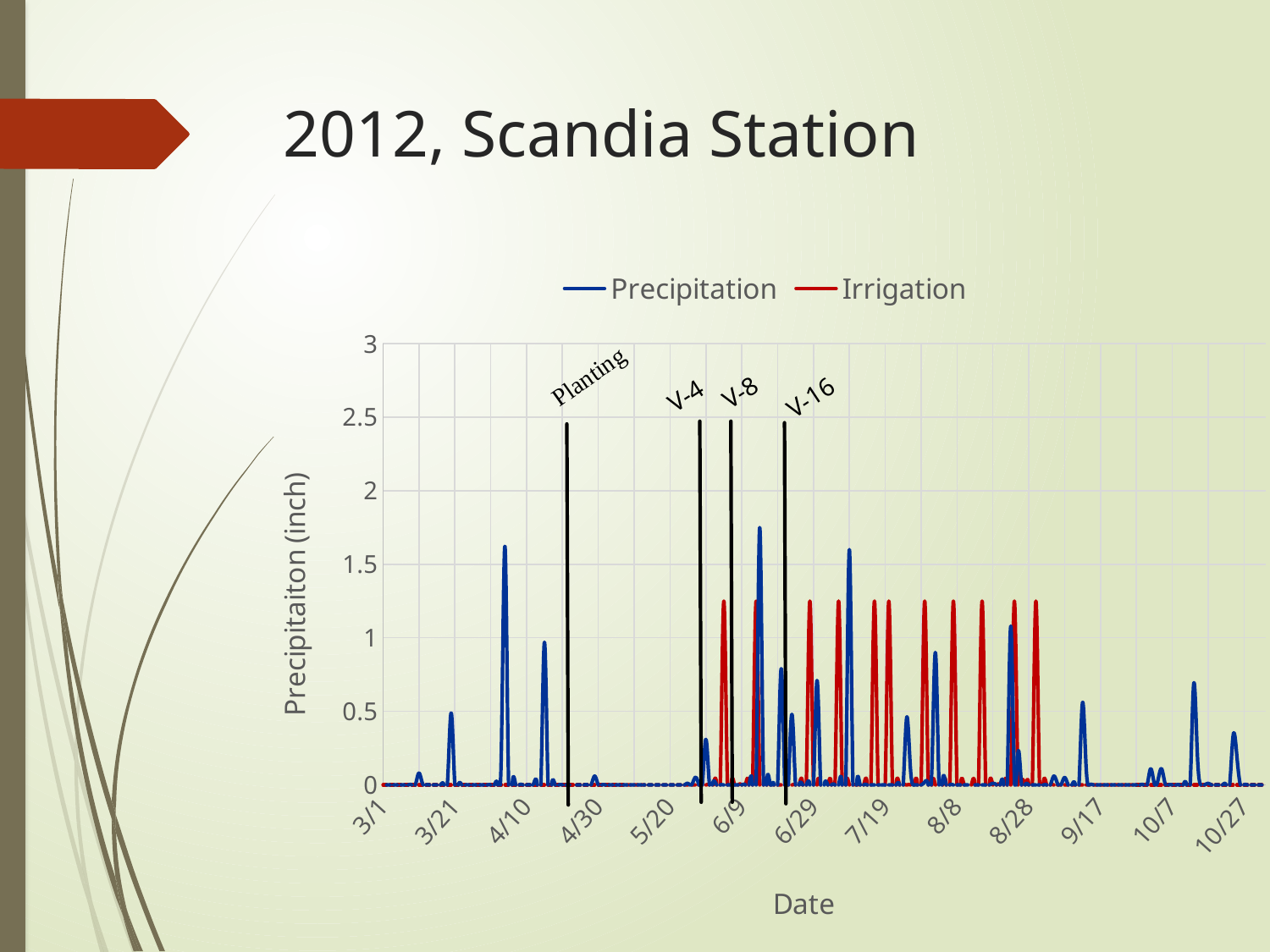
How many series does the legend list? 2 Is the highest Precipitation value greater or less than 2? less Is the highest Irrigation value greater or less than 1.5? less Is the highest Precipitation value greater or less than 1.5? greater What is the title of the chart on the slide? 2012, Scandia Station Which series is drawn in red? Irrigation What is the label of the vertical axis? Precipitaiton (inch) How many date labels are shown on the x axis? 13 Which series reaches a higher peak value, Precipitation or Irrigation? Precipitation How many labelled vertical marker lines (Planting, V-4, V-8, V-16) are drawn on the chart? 4 What kind of chart is shown on the slide? Line chart